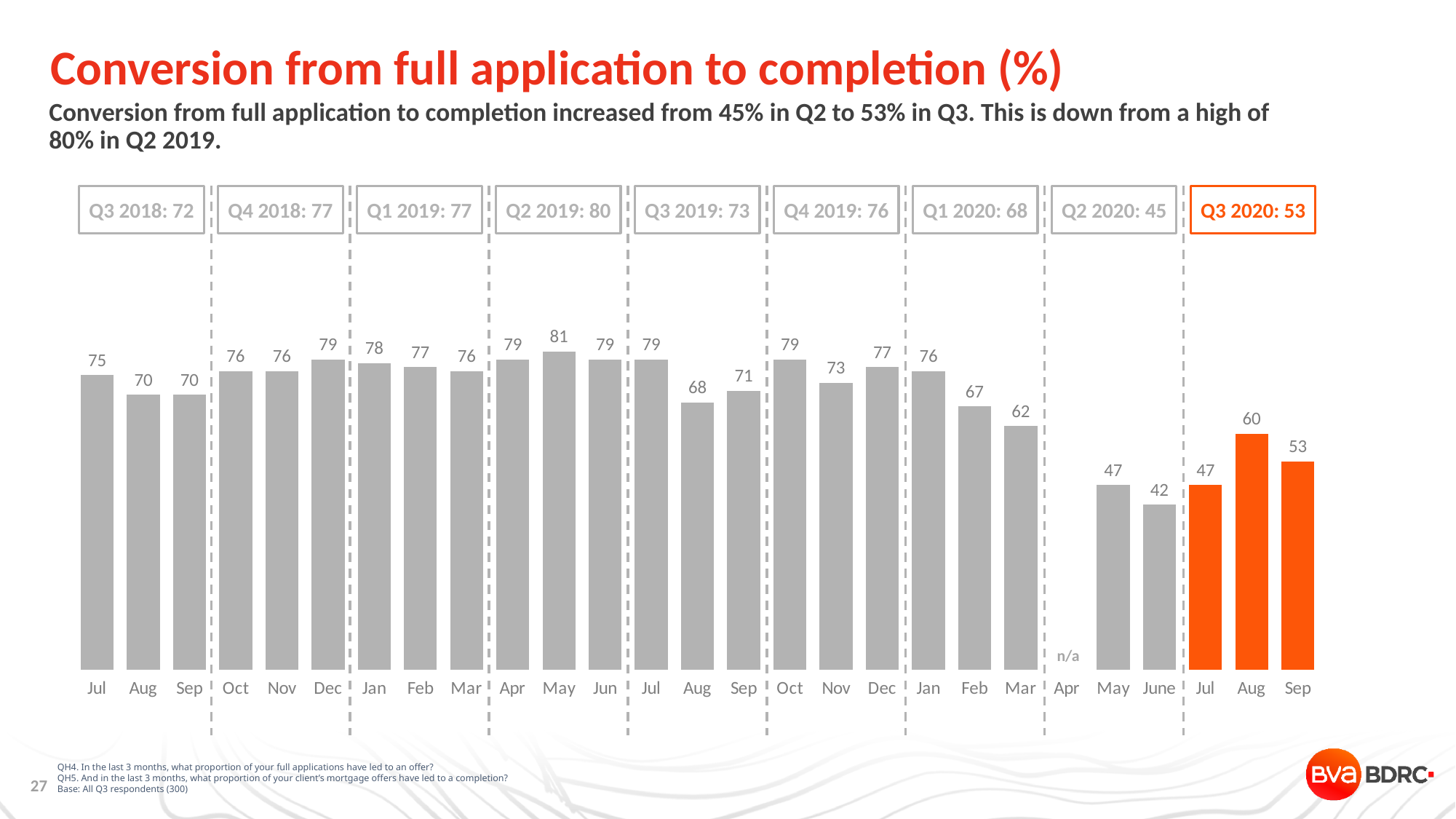
Which month in the chart is marked as n/a with no bar? Apr (Q2 2020) Which month has the lowest plotted value in the chart? June (Q2 2020) What is the value for Aug in the Q3 2020 section? 60 What is the difference between the Aug and Sep values in the Q3 2020 section? 7 What is the value for May in the Q2 2019 section? 81 Which bars are coloured orange rather than grey? Jul, Aug and Sep in Q3 2020 Which month has the highest value in the chart? May (Q2 2019) What quarterly value is shown in the box for Q2 2019? 80 What type of chart is shown on the slide? bar chart What is the value for June in the Q2 2020 section? 42 Which is larger: the value for Mar in Q1 2020 or the value for Feb in Q1 2020? Feb in Q1 2020 How many month labels are shown along the x axis? 27